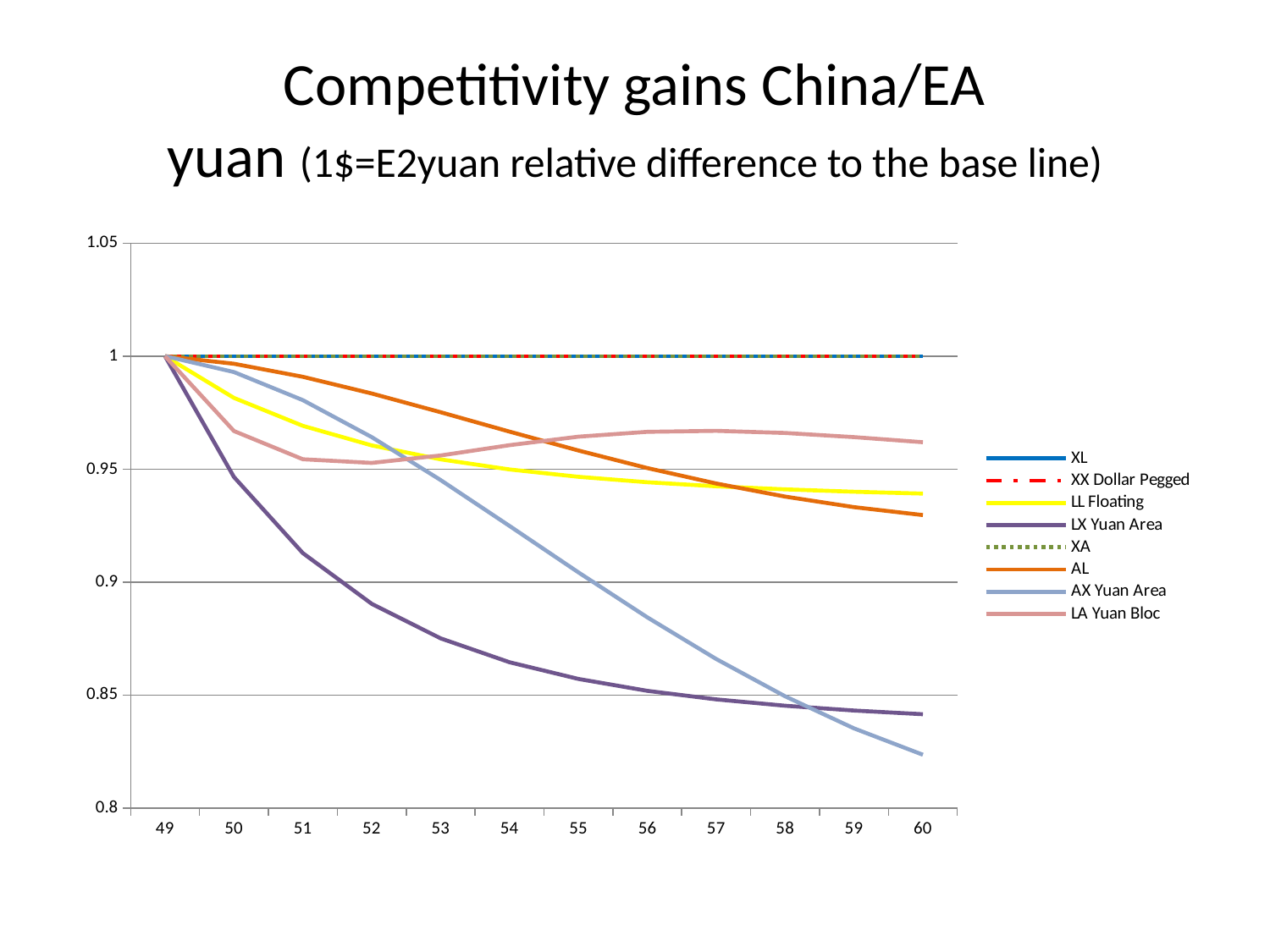
Is the value for AL at 60 greater or less than 0.9? greater Is the value for AX Yuan Area at 60 greater or less than 0.85? less How many points are on the x axis? 12 What kind of chart is shown on the slide? line chart Does the LX Yuan Area series rise or fall from 49 to 60? fall Is the value for LA Yuan Bloc at 60 greater or less than 0.95? greater How many series does the legend list? 8 At 60, which is larger: AL or LL Floating? LL Floating Which series has the lowest value at 55? LX Yuan Area What is the value of the XL series at 60? 1 What is the value of the LX Yuan Area series at 49? 1 Which series has the lowest value at 60? AX Yuan Area